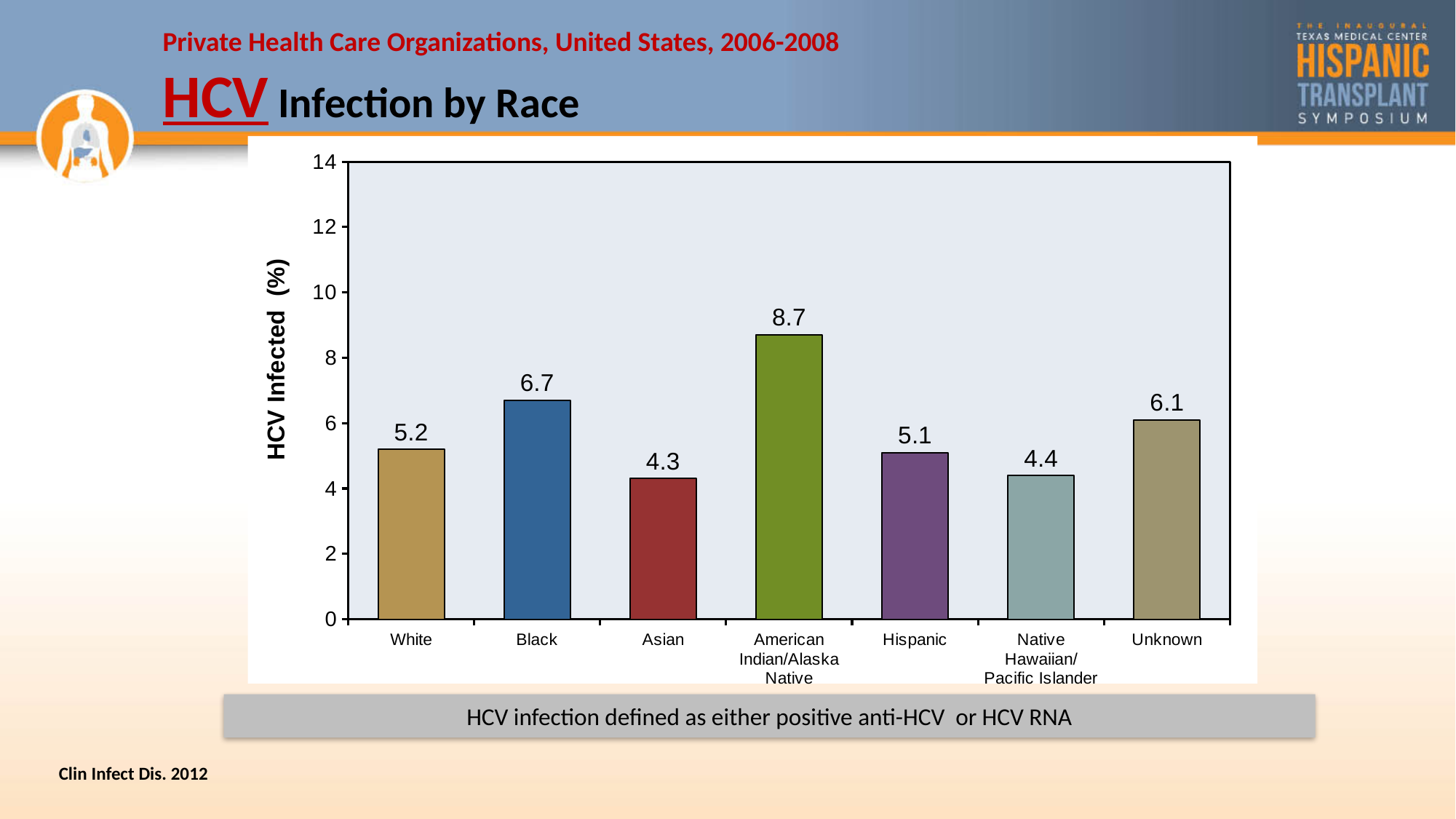
Which race category has the highest HCV infected percentage? American Indian/Alaska Native What is the HCV infected percentage for American Indian/Alaska Native? 8.7 What is the HCV infected percentage for White? 5.2 Which has a higher HCV infected percentage, Black or Unknown? Black Which race category has the lowest HCV infected percentage? Asian What is the label of the y axis? HCV Infected (%) What is the difference between the HCV infected percentage for American Indian/Alaska Native and for Asian? 4.4 How many race categories are shown on the chart? 7 What is the difference between the HCV infected percentage for Black and for White? 1.5 What is the HCV infected percentage for Native Hawaiian/Pacific Islander? 4.4 What kind of chart is shown on the slide? bar chart Is the HCV infected percentage for Hispanic greater or less than 6? less